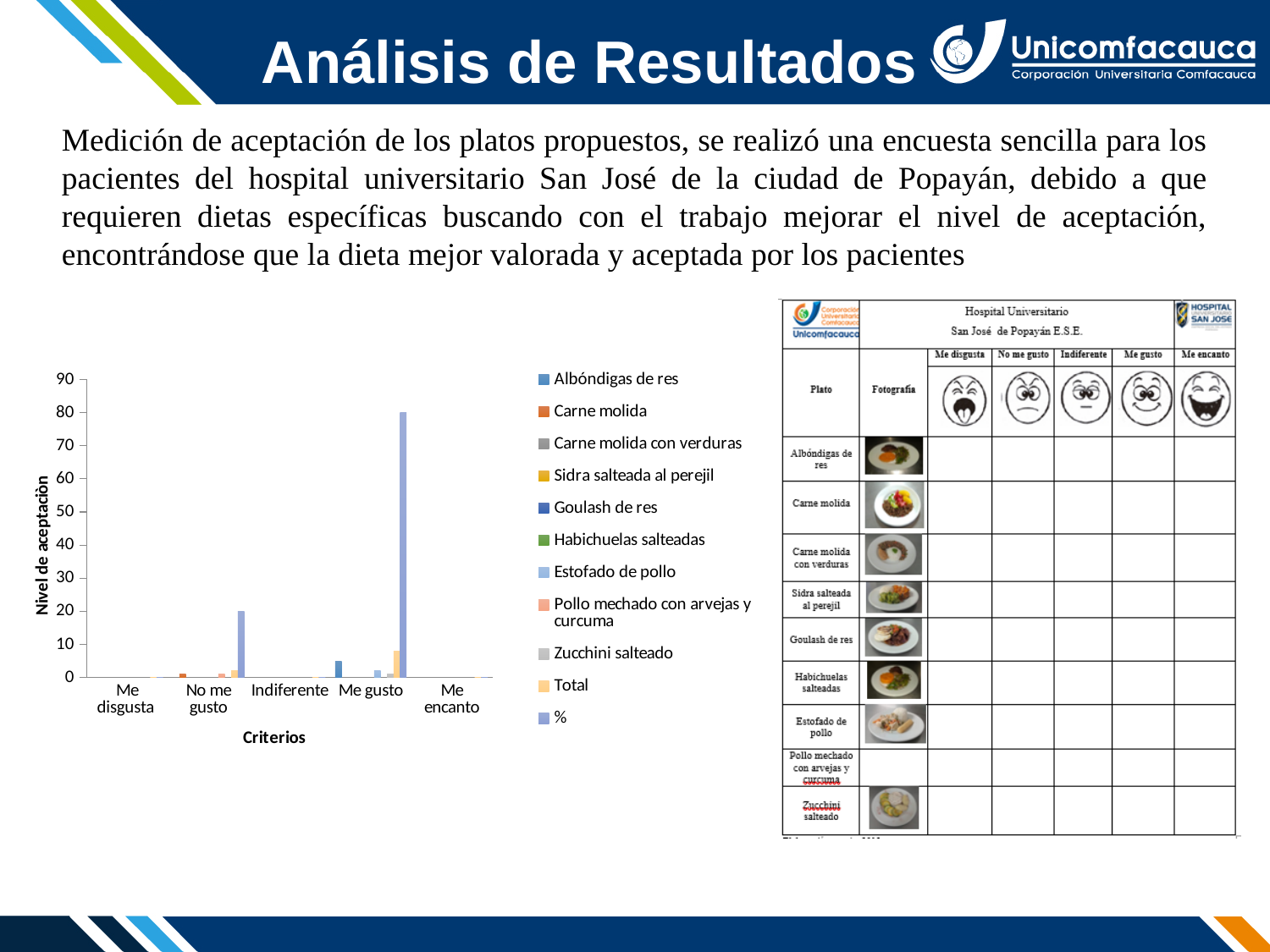
How many series does the chart legend list? 11 Is the value of the % series for No me gusto greater or less than 30? less What kind of chart is shown on the slide? bar chart Which category on the x axis has the tallest bar? Me gusto What is the value of the % series for Me gusto? 80 What is the title of the horizontal axis of the chart? Criterios What is the value of the % series for No me gusto? 20 How many categories are shown on the x axis of the chart? 5 Which is larger, the % value for Me gusto or the % value for No me gusto? Me gusto Is the value of the % series for Me gusto greater or less than 70? greater Is the value of the Total series for Me gusto greater or less than 10? less What is the title of the vertical axis of the chart? Nivel de aceptación